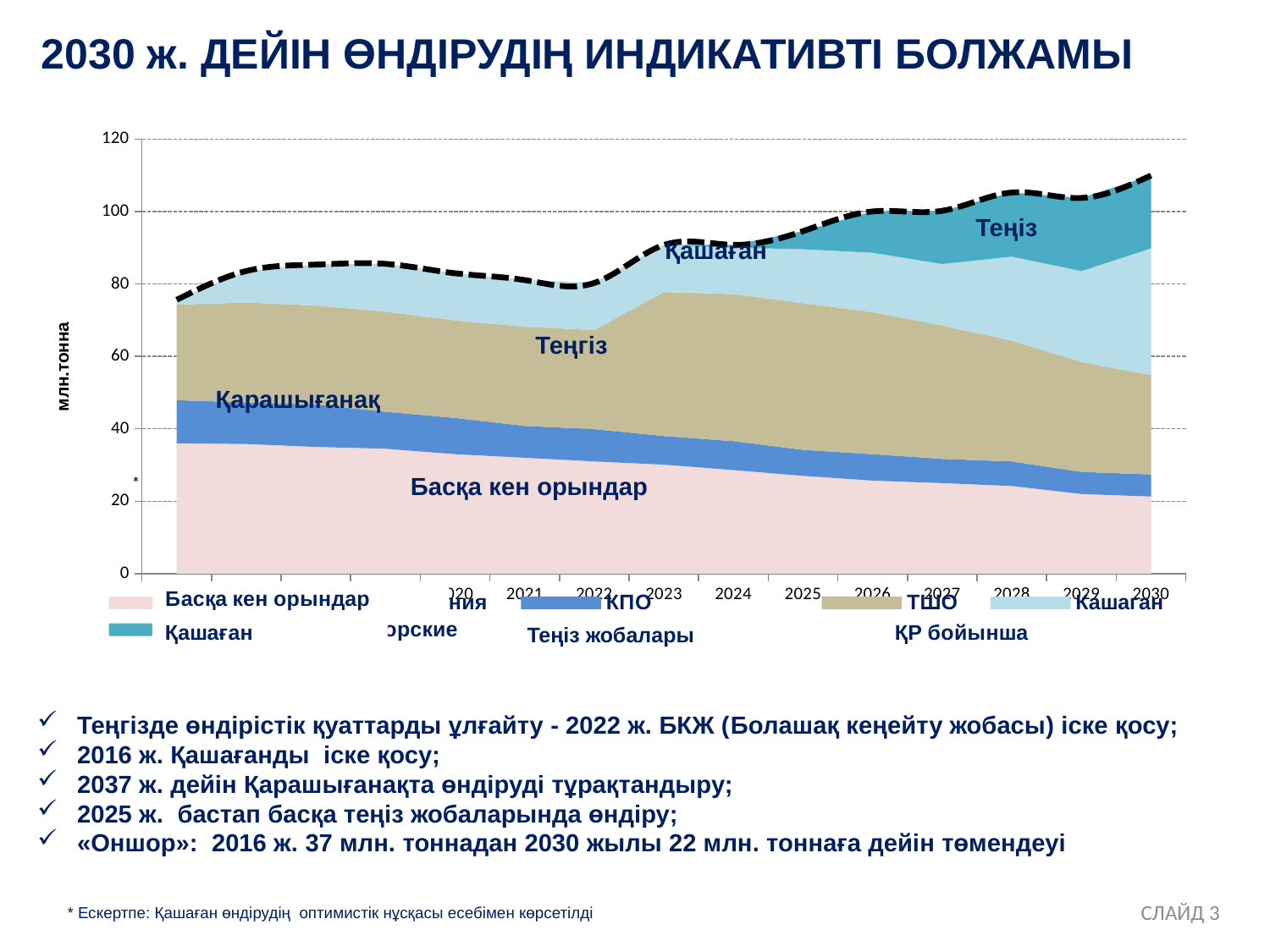
What is the highest value shown on the vertical axis of the chart? 120 What unit is shown on the vertical axis of the chart? млн.тонна Does the Басқа кен орындар area rise or fall from 2021 to 2030? fall What kind of chart is shown on the slide? Stacked area chart Is the value of the Басқа кен орындар area in 2030 greater or less than 40? less Which area is at the bottom of the stacked chart? Басқа кен орындар Is the total (dashed line) for 2021 greater or less than 100? less Does the dashed total line rise or fall overall from 2021 to 2030? rise Is the total (dashed line) for 2030 greater or less than 100? greater What is the title of the chart on the slide? 2030 ж. ДЕЙІН ӨНДІРУДІҢ ИНДИКАТИВТІ БОЛЖАМЫ